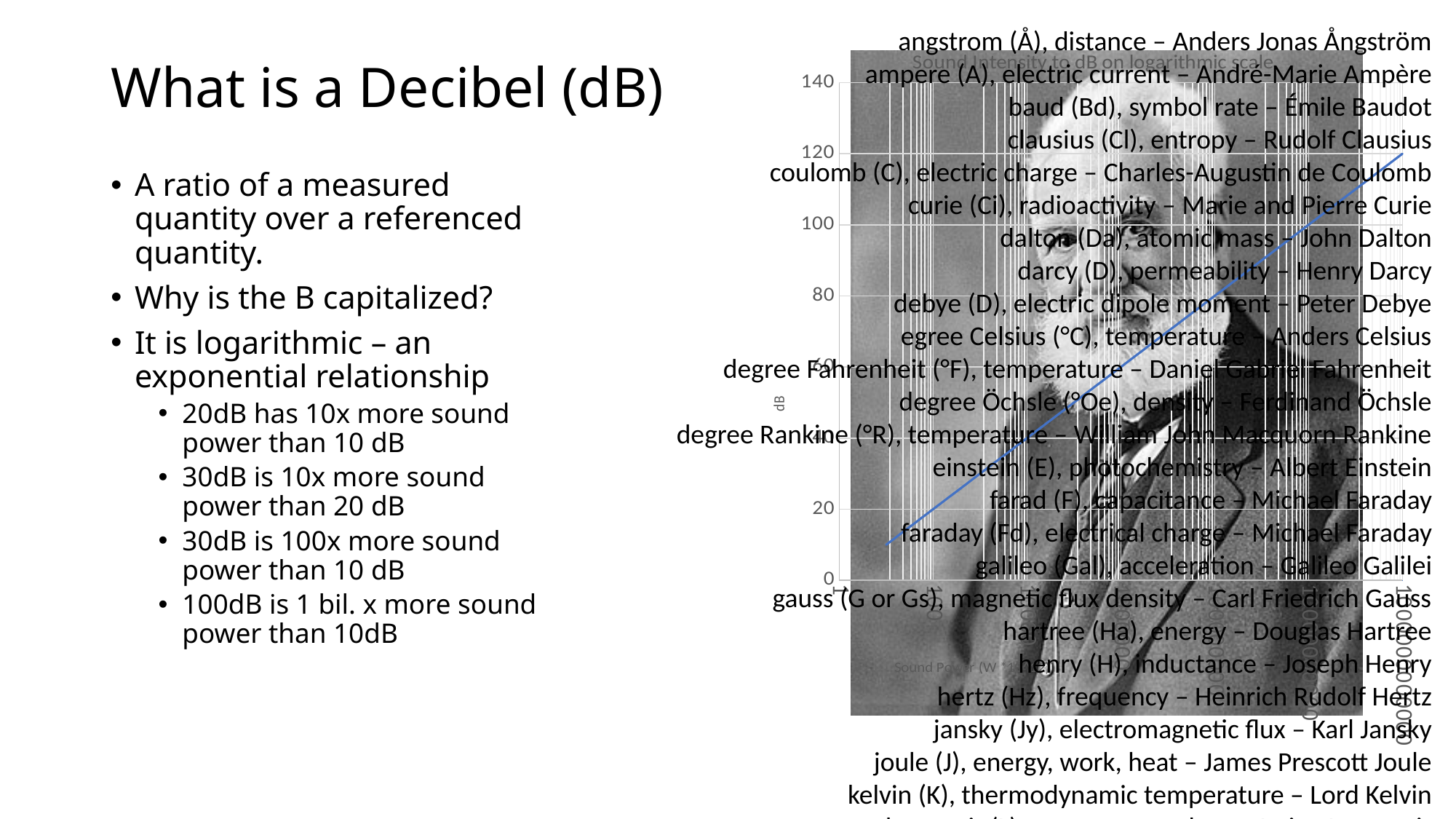
Is the highest plotted dB value on the line greater or less than 100? greater What kind of chart is shown on the right side of the slide? line chart Do the dB values rise or fall as sound power increases along the x axis? rise What is the label on the vertical axis of the chart? dB What is the title of the chart on the slide? Sound Intensity to dB on logarithmic scale Is the lowest plotted dB value on the line greater or less than 20? less